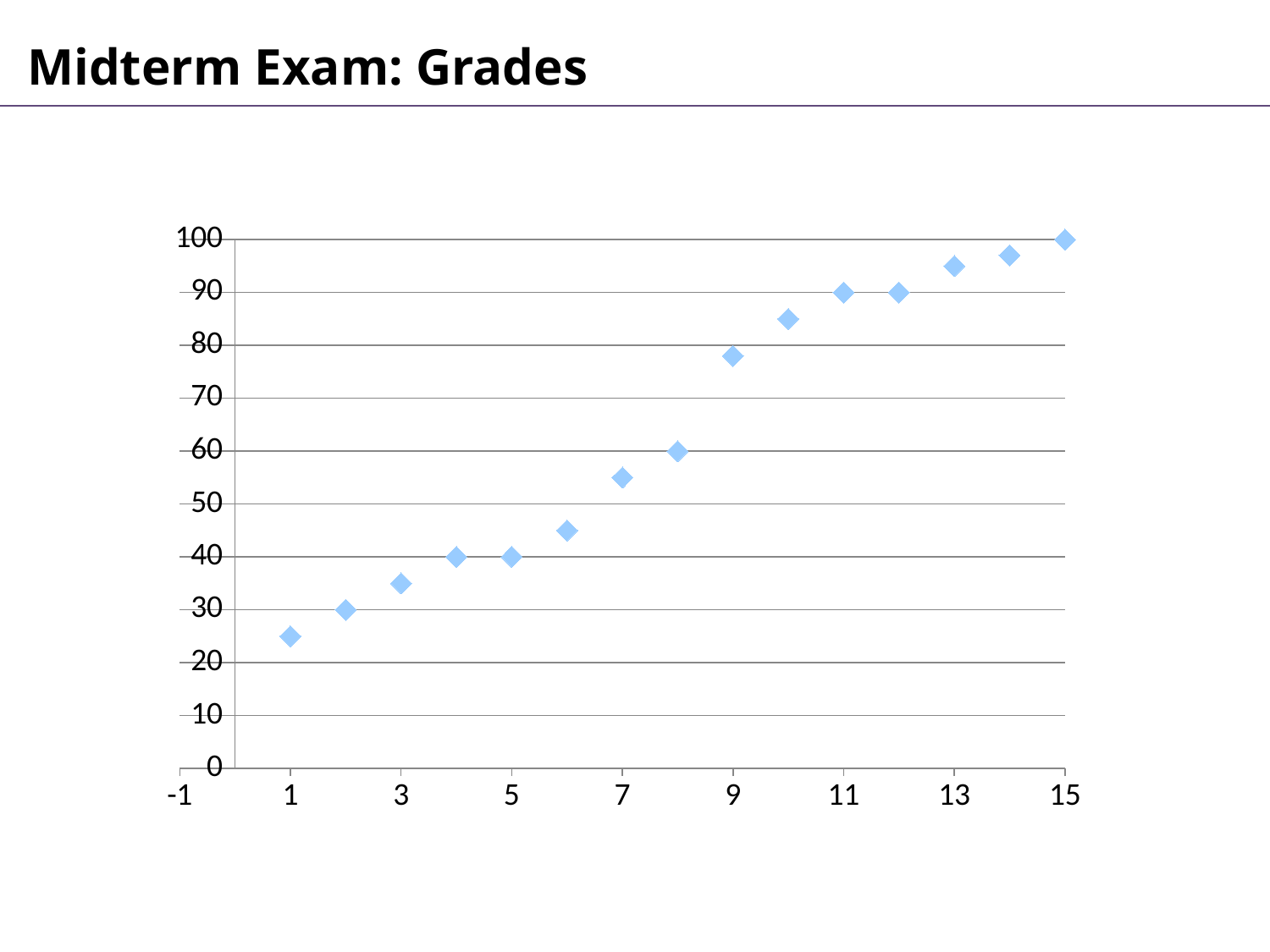
What is the title of the slide containing the chart? Midterm Exam: Grades Do the plotted values rise or fall as x increases from 1 to 15? rise What is the difference between the plotted values at x = 15 and x = 4? 60 What is the plotted value at x = 11? 90 What kind of chart is shown on the slide? scatter chart How many data points are plotted on the chart? 15 What is the plotted value at x = 15? 100 Which has the larger plotted value, x = 8 or x = 2? x = 8 At which x value is the plotted value lowest? 1 At which x value is the plotted value highest? 15 Is the plotted value at x = 9 greater or less than 70? greater What is the plotted value at x = 8? 60